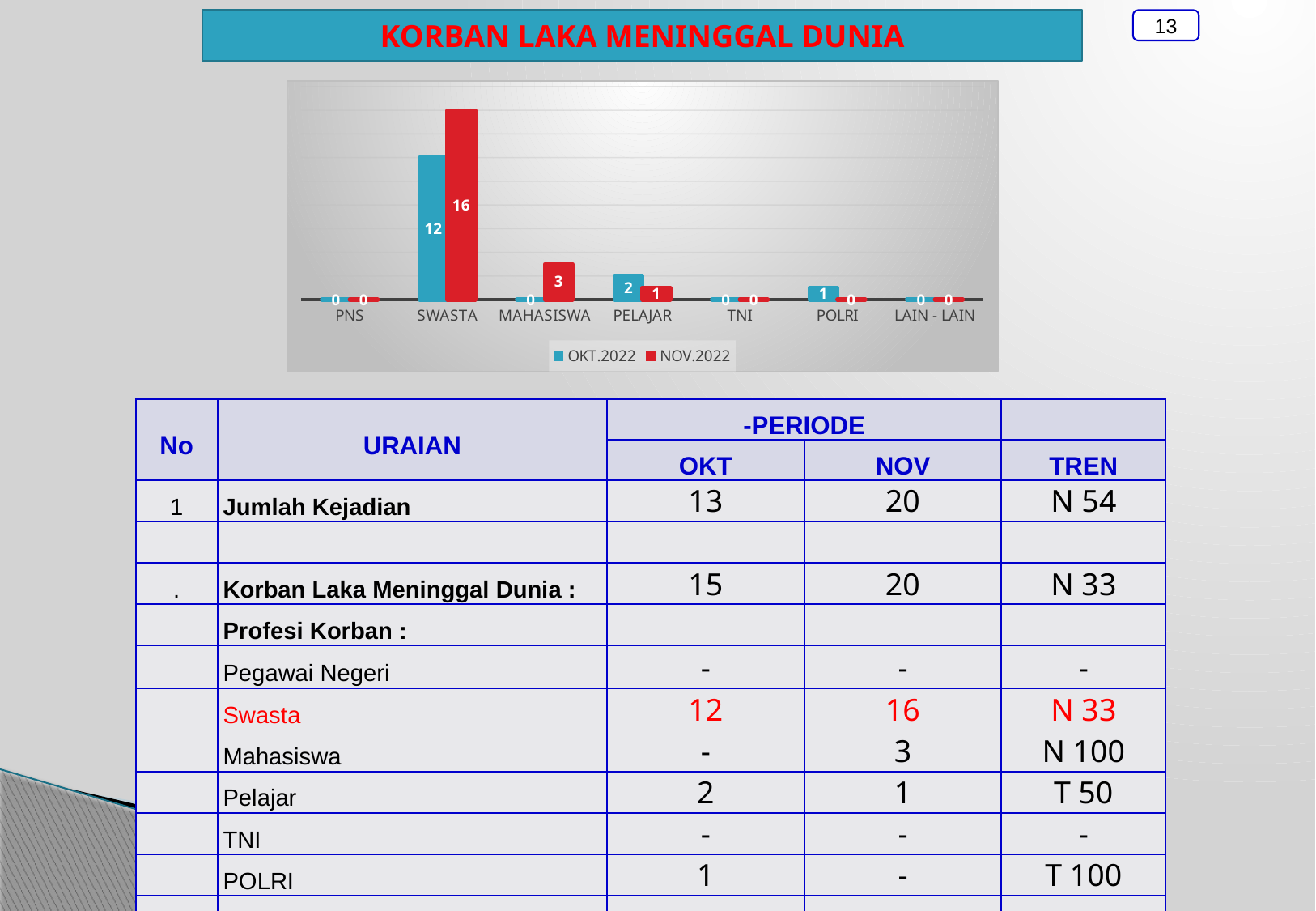
What is the NOV.2022 value for MAHASISWA? 3 What is the difference between the NOV.2022 and OKT.2022 values for SWASTA? 4 What is the OKT.2022 value for POLRI? 1 What is the title of the chart on the slide? KORBAN LAKA MENINGGAL DUNIA How many series does the chart legend list? 2 What is the OKT.2022 value for SWASTA? 12 What is the NOV.2022 value for SWASTA? 16 What is the OKT.2022 value for PELAJAR? 2 Which is larger for PELAJAR, the OKT.2022 value or the NOV.2022 value? OKT.2022 How many categories are shown on the x axis of the chart? 7 Which category has the highest NOV.2022 value? SWASTA What kind of chart is shown on the slide? bar chart